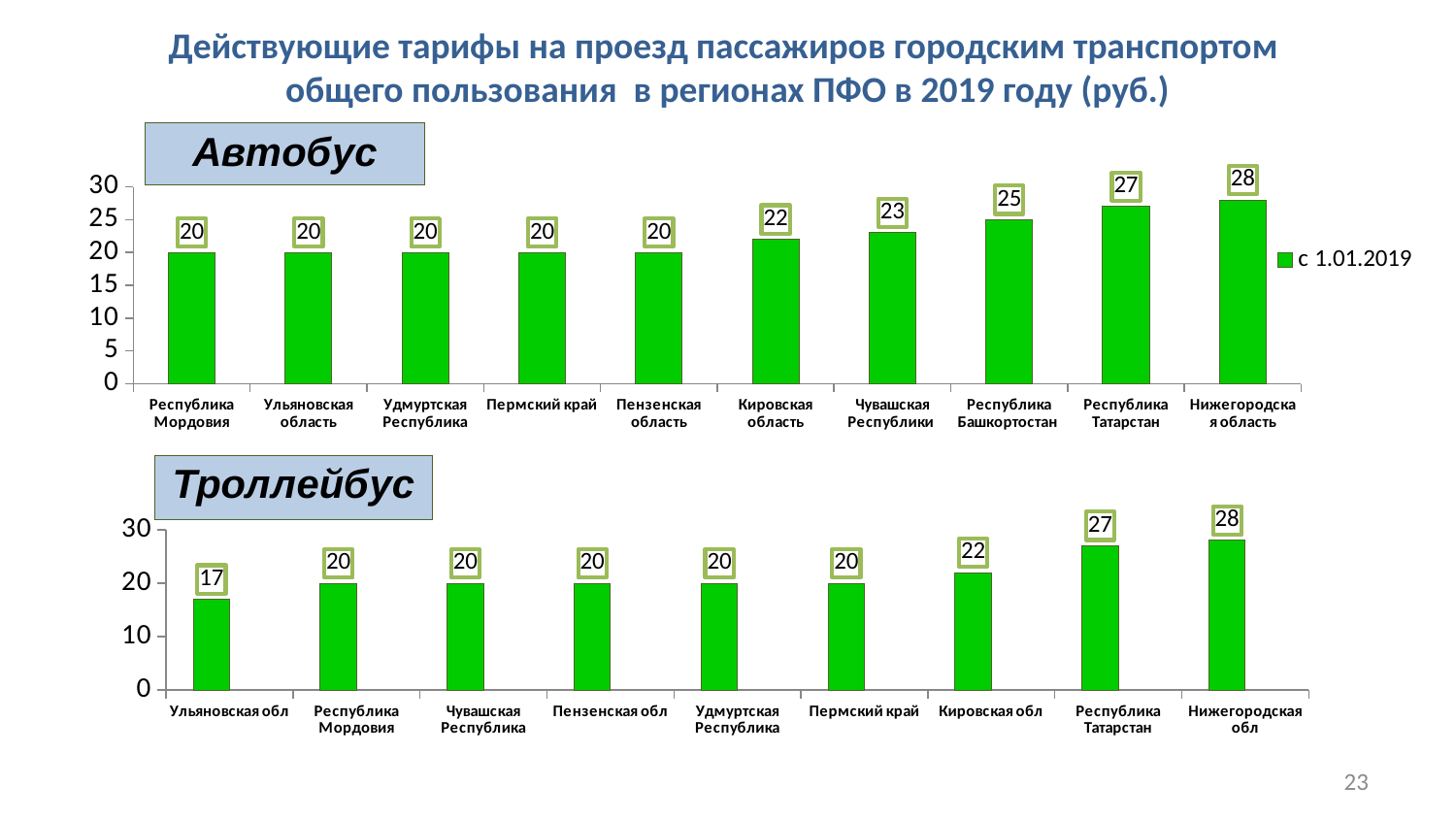
In the Автобус chart, what is the value for Республика Башкортостан? 25 In the Троллейбус chart, which region has the lowest value? Ульяновская обл In the Автобус chart, which region has the highest value? Нижегородская область In the Автобус chart, how many regions are shown? 10 In the Троллейбус chart, how many regions are shown? 9 What type of chart is the Троллейбус chart? Bar chart In the Троллейбус chart, which is larger: Республика Татарстан or Кировская обл? Республика Татарстан In the Автобус chart, what is the difference between Нижегородская область and Кировская область? 6 In the Автобус chart, what is the value for Чувашская Республики? 23 In the Троллейбус chart, what is the value for Ульяновская обл? 17 In the Автобус chart, what is the legend entry? с 1.01.2019 In the Троллейбус chart, what is the difference between Республика Татарстан and Ульяновская обл? 10